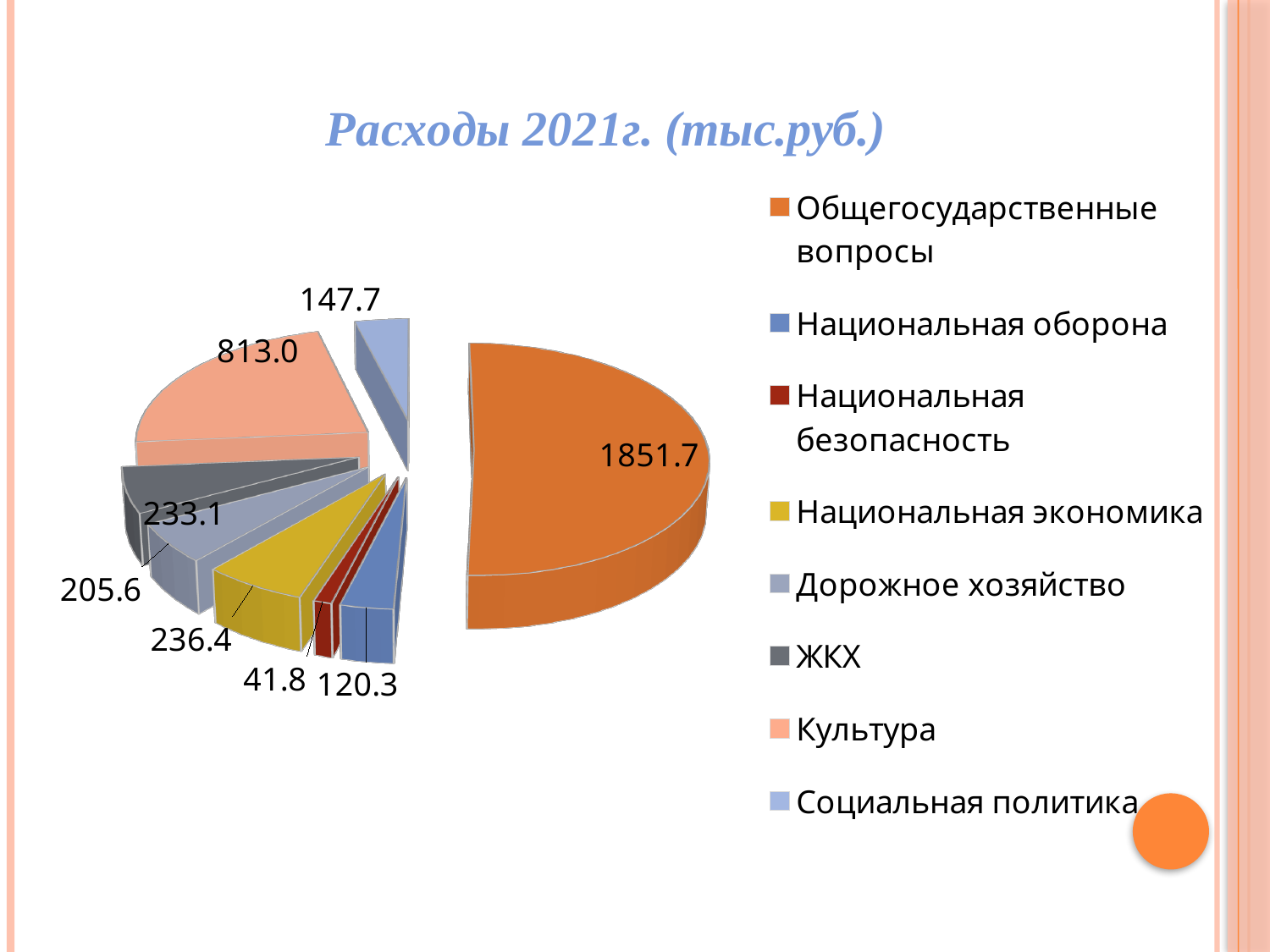
What type of chart is shown on the slide? Pie chart Which category has the largest value? Общегосударственные вопросы Which is larger, the value for Национальная экономика or the value for ЖКХ? Национальная экономика What is the value for Культура? 813.0 What is the value for Дорожное хозяйство? 205.6 Which category has the smallest value? Национальная безопасность What is the title of the chart? Расходы 2021г. (тыс.руб.) What is the difference between the values for Культура and Социальная политика? 665.3 What colour is the slice for Национальная экономика? Yellow How many categories does the pie chart have? 8 What is the value for Национальная безопасность? 41.8 What is the value for Общегосударственные вопросы? 1851.7